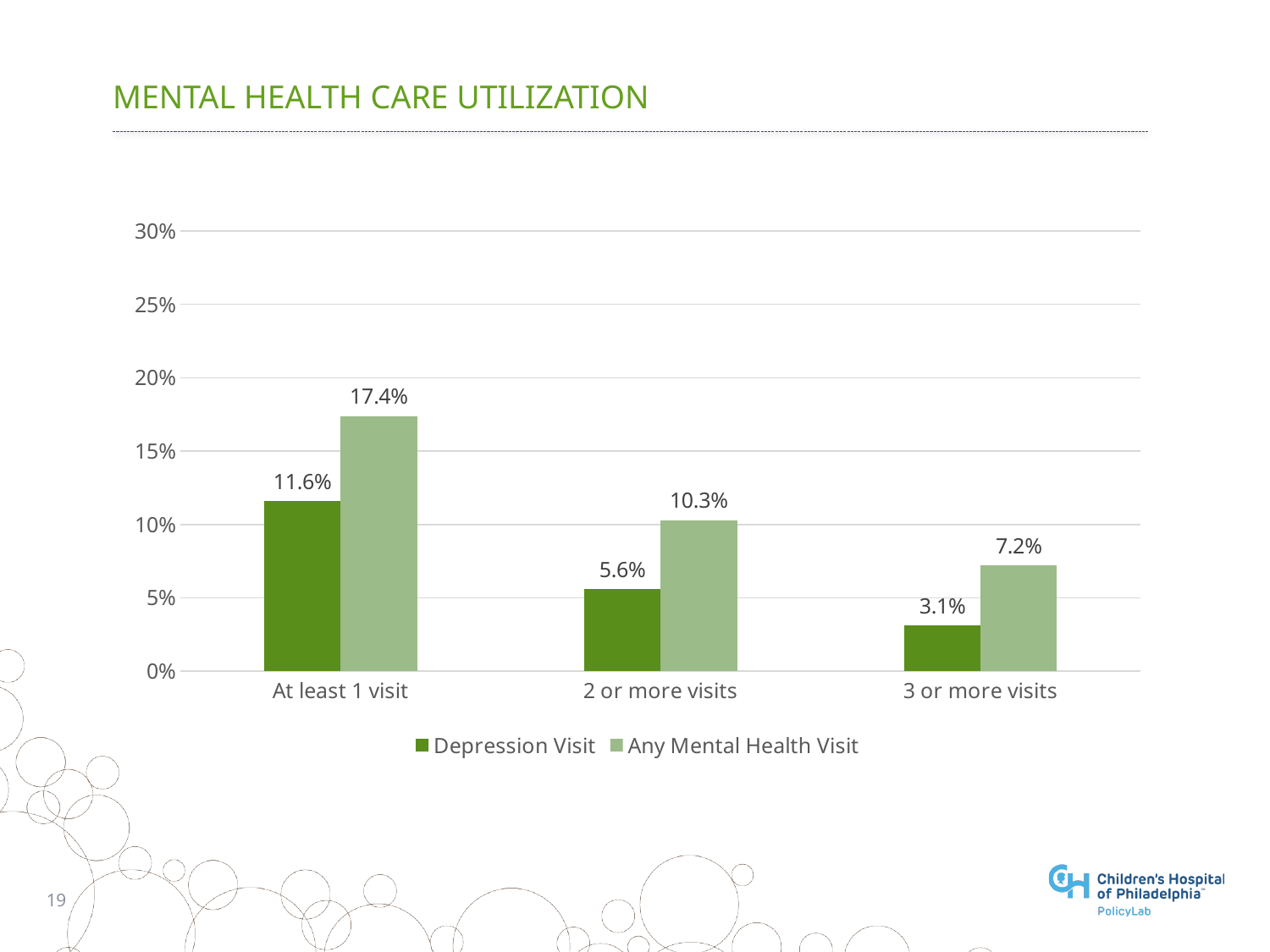
What is the difference between Any Mental Health Visit and Depression Visit in the 'At least 1 visit' category? 5.8% Which category has the lowest value for Depression Visit? 3 or more visits What is the value for Any Mental Health Visit in the '2 or more visits' category? 10.3% What is the value for Depression Visit in the '3 or more visits' category? 3.1% Is the value for Any Mental Health Visit in the '3 or more visits' category greater or less than 10%? less How many series does the legend list? 2 What is the value for Depression Visit in the 'At least 1 visit' category? 11.6% How many categories are shown on the x axis? 3 Do the Depression Visit values rise or fall from 'At least 1 visit' to '3 or more visits'? Fall Which category has the highest value for Any Mental Health Visit? At least 1 visit What kind of chart is shown on the slide? Bar chart Which is larger in the '2 or more visits' category: Depression Visit or Any Mental Health Visit? Any Mental Health Visit